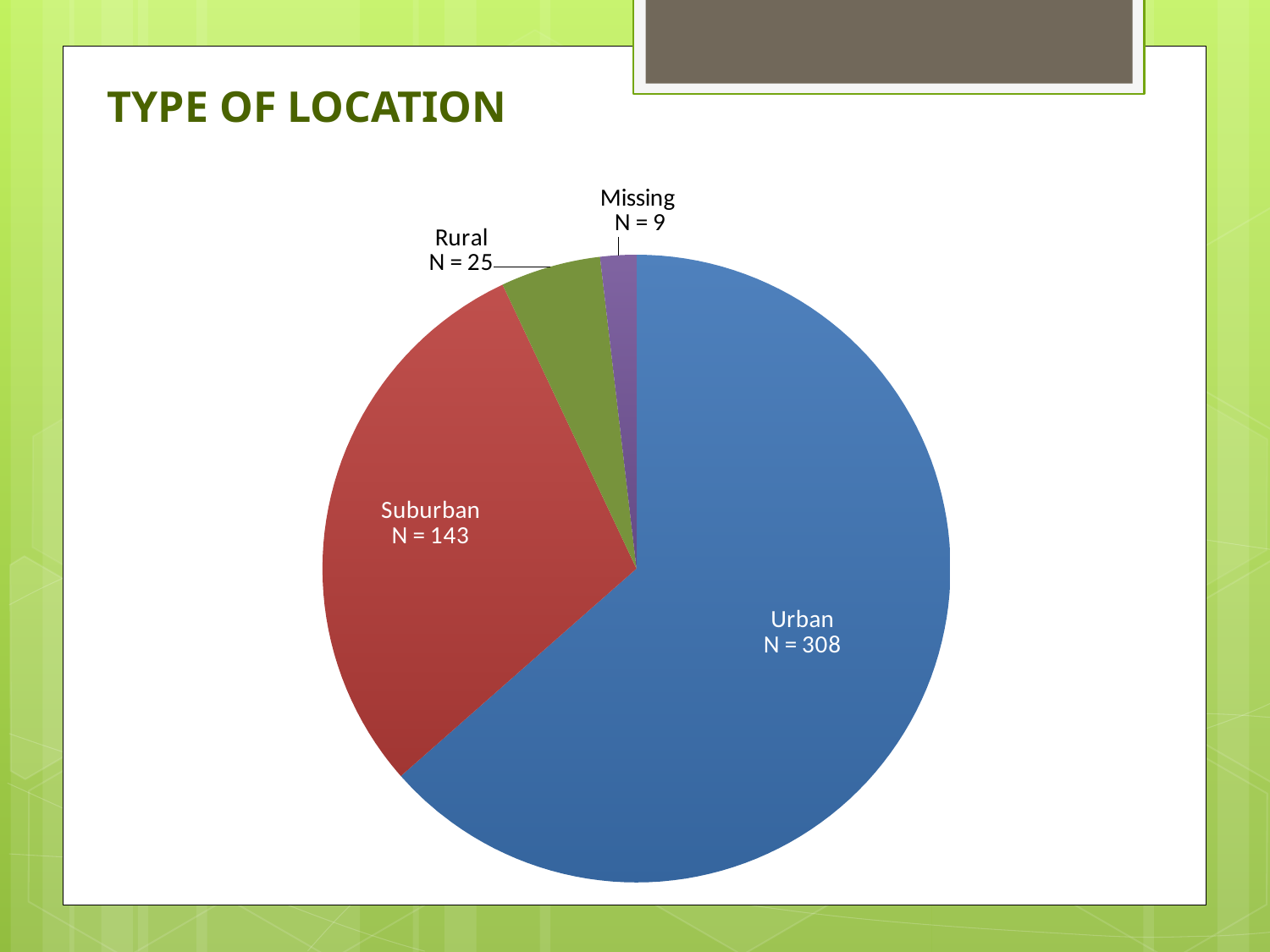
Which location type has the smallest slice of the pie? Missing What kind of chart is shown on the slide? Pie chart How many slices does the pie chart have? 4 Which is larger, the Rural N value or the Missing N value? Rural What is the N value for the Suburban slice? 143 What is the N value for the Rural slice? 25 What is the difference between the Urban and Suburban N values? 165 What is the N value for the Missing slice? 9 What is the N value for the Urban slice? 308 What is the total N across all slices of the pie? 485 What is the title of the slide containing the pie chart? TYPE OF LOCATION Which location type has the largest slice of the pie? Urban